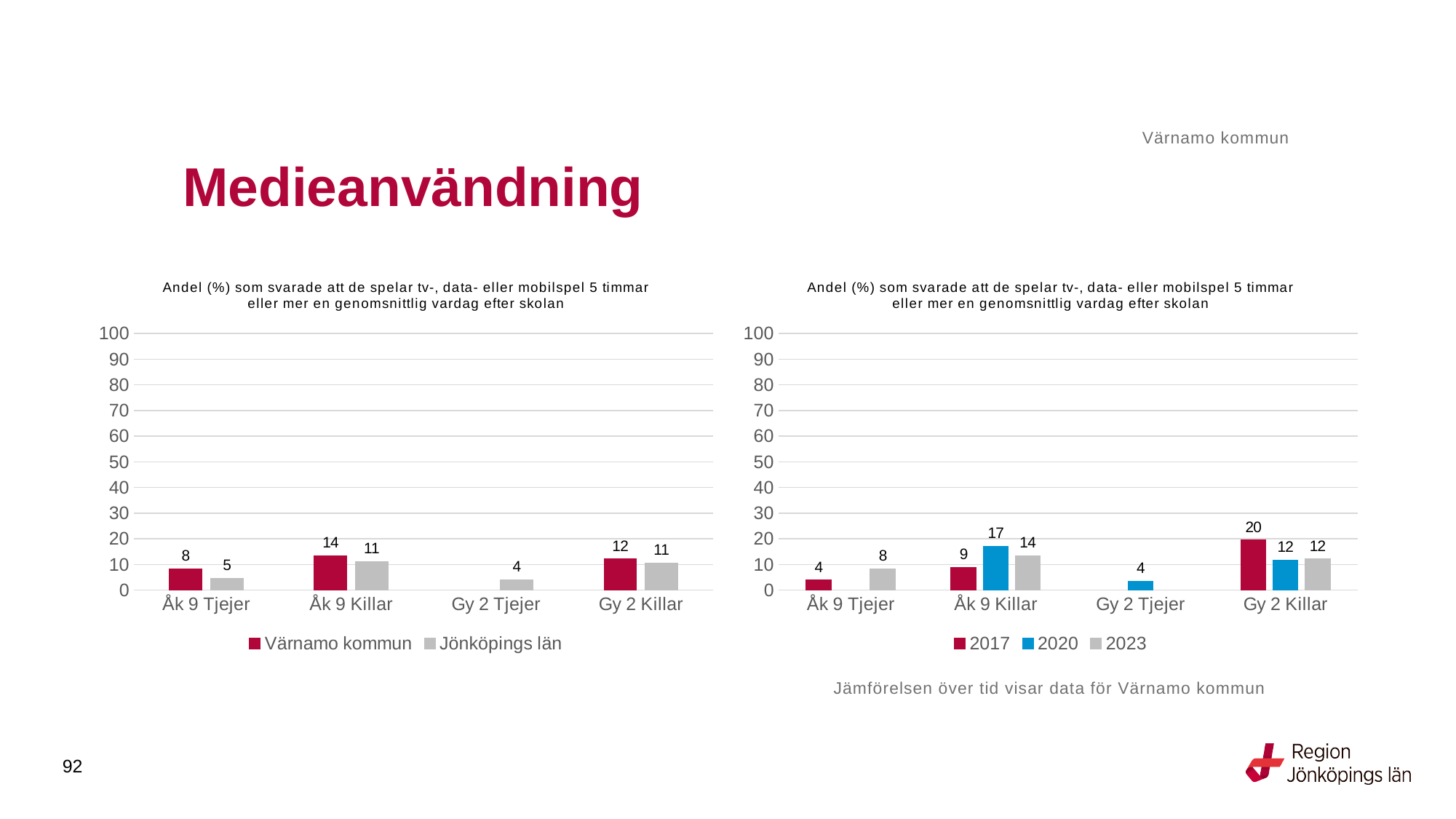
In the left chart, which category has the highest value for Värnamo kommun? Åk 9 Killar In the left chart, how many series does the legend list? 2 In the left chart, what is the difference between Värnamo kommun and Jönköpings län for Åk 9 Tjejer? 3 In the right chart, how many series does the legend list? 3 In the left chart, what is the value for Värnamo kommun for Åk 9 Killar? 14 In the right chart, what is the value for 2017 for Gy 2 Killar? 20 In the right chart, what is the value for 2020 for Åk 9 Killar? 17 What kind of chart is the left chart? Bar chart In the right chart, what is the difference between the 2017 and 2023 values for Åk 9 Tjejer? 4 In the right chart, which year has the lowest value for Åk 9 Killar? 2017 In the right chart, is the 2017 value for Gy 2 Killar larger or smaller than the 2020 value for Gy 2 Killar? larger In the left chart, what is the value for Jönköpings län for Gy 2 Tjejer? 4